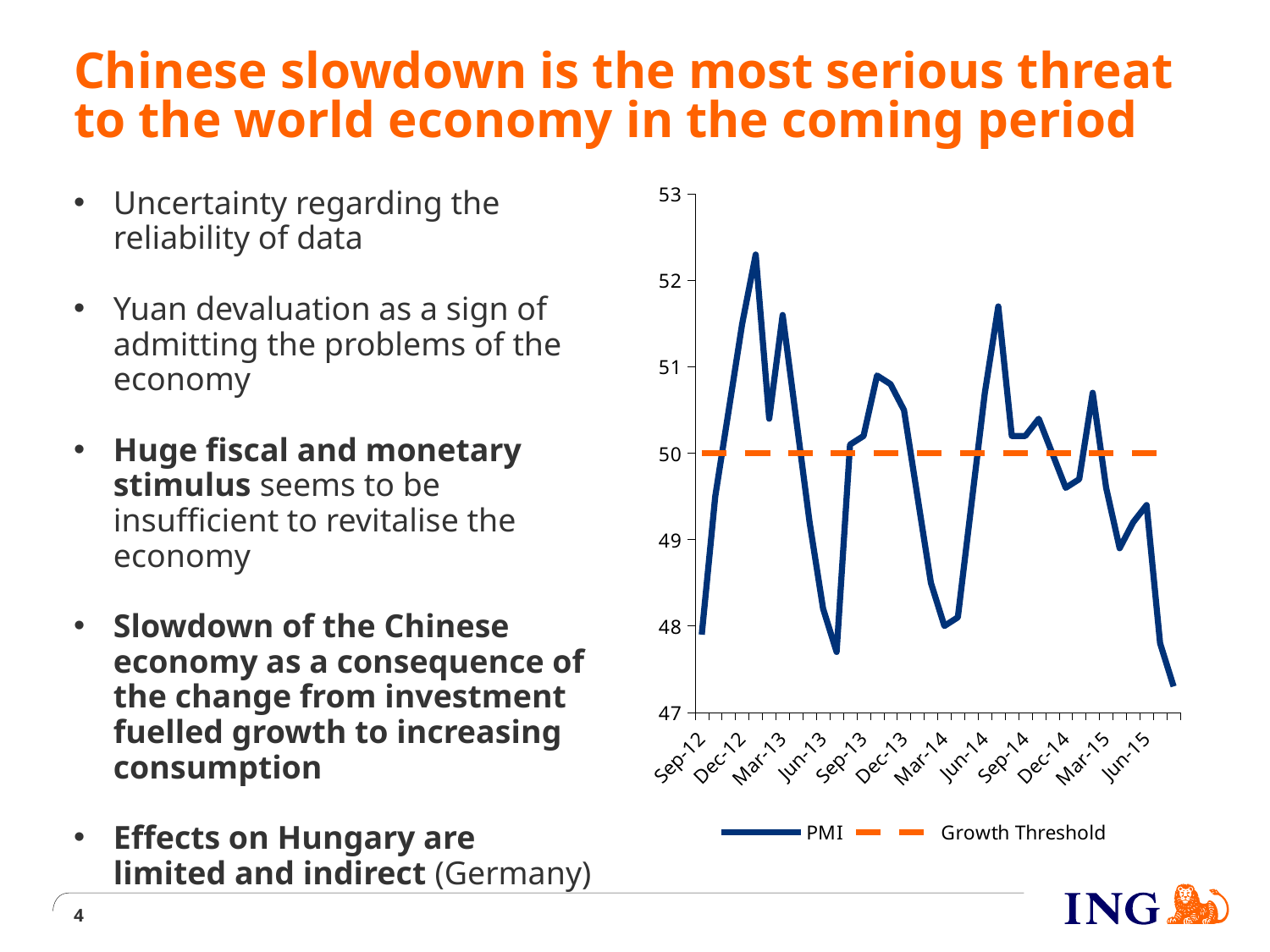
How many series does the chart legend list? 2 At what value does the Growth Threshold line sit? 50 From Mar-15 to the end of the series, does the PMI line rise or fall overall? fall Is the PMI value at Jun-13 greater or less than 50? less Is the PMI value at Mar-14 greater or less than 49? less Is the PMI value at Dec-12 greater or less than 50? greater What are the two series named in the chart legend? PMI and Growth Threshold What kind of chart is shown on the slide? line chart How many date labels are shown on the x axis of the chart? 12